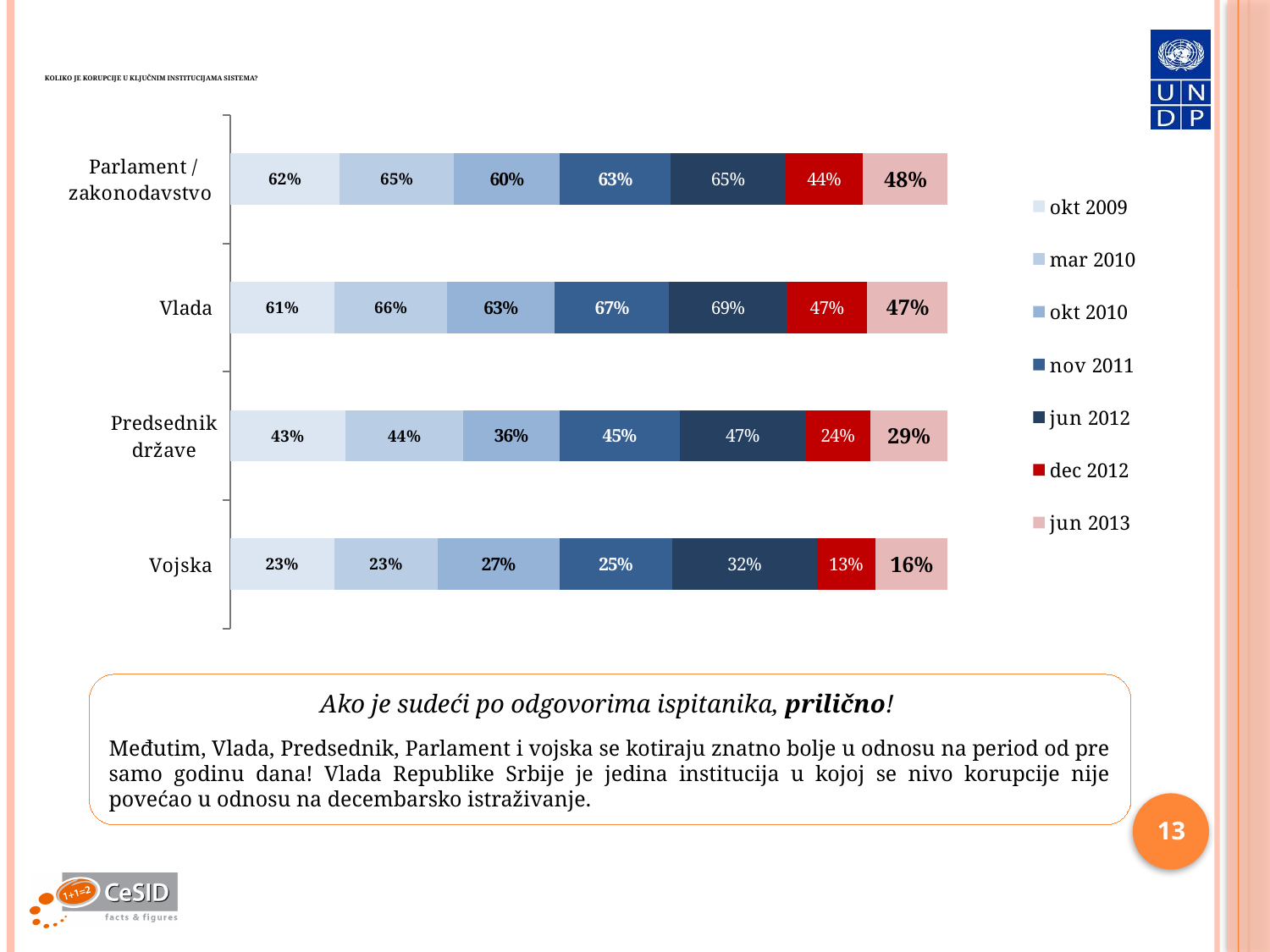
What is the value for Vojska in jun 2012? 32% How many institutions (categories) are shown on the chart? 4 Which institution has the lowest value in jun 2013? Vojska What is the value for Predsednik države in dec 2012? 24% Which institution has the highest value in nov 2011? Vlada What is the value for Parlament / zakonodavstvo in okt 2009? 62% How many series does the legend list? 7 What kind of chart is shown on the slide? stacked bar chart Which series is shown in red in the legend? dec 2012 What is the value for Vlada in jun 2013? 47% Which is larger for Parlament / zakonodavstvo: the mar 2010 value or the okt 2010 value? mar 2010 What is the difference between the dec 2012 and jun 2013 values for Predsednik države? 5%